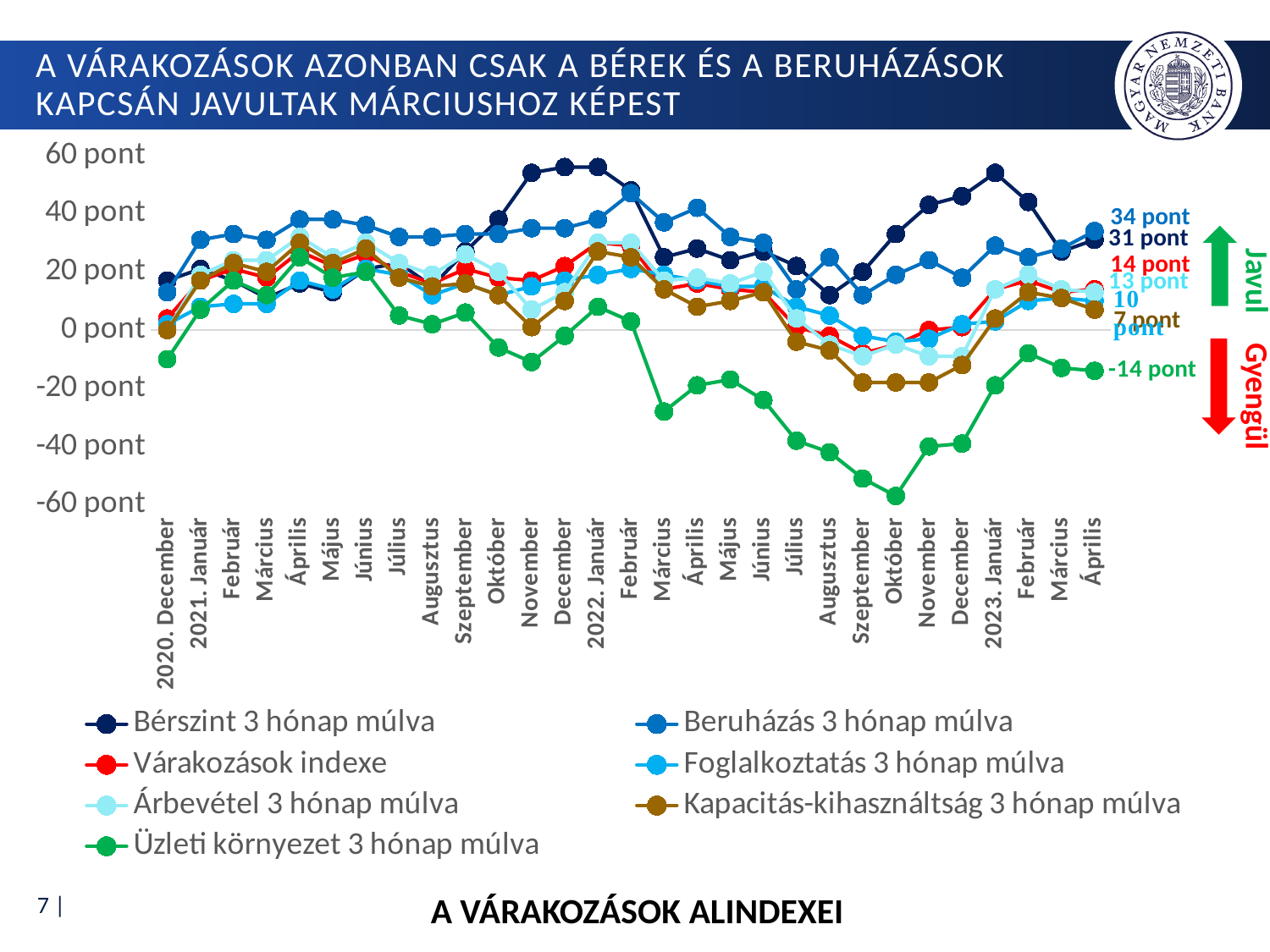
How many series does the legend list? 7 What is the value of Beruházás 3 hónap múlva in 2023 Április? 34 pont In 2023 Április, which is larger: Foglalkoztatás 3 hónap múlva or Kapacitás-kihasználtság 3 hónap múlva? Foglalkoztatás 3 hónap múlva Is the value of Bérszint 3 hónap múlva in 2021 December greater or less than 40 pont? greater What kind of chart is shown on the slide? Line chart What is the difference between Beruházás 3 hónap múlva and Bérszint 3 hónap múlva in 2023 Április? 3 pont Which series has the highest value in 2023 Április? Beruházás 3 hónap múlva Is the value of Üzleti környezet 3 hónap múlva in 2022 Október greater or less than -40 pont? less What is the value of Bérszint 3 hónap múlva in 2023 Április? 31 pont What is the value of Várakozások indexe in 2023 Április? 14 pont What is the value of Üzleti környezet 3 hónap múlva in 2023 Április? -14 pont Which series has the lowest value in 2023 Április? Üzleti környezet 3 hónap múlva